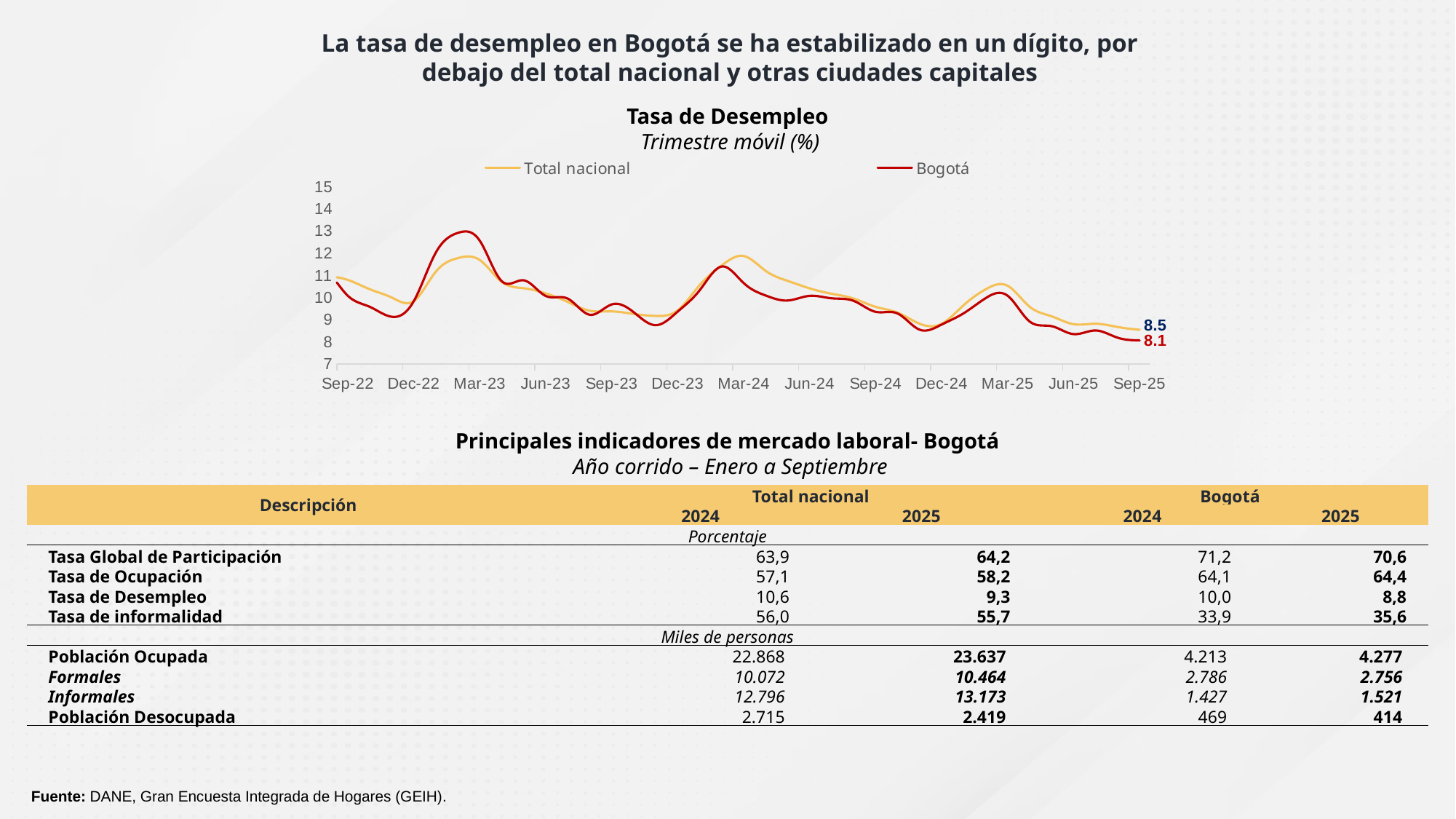
How many date labels are shown on the x axis of the Tasa de Desempleo chart? 13 How many series does the legend of the Tasa de Desempleo chart list? 2 Is the value for Bogotá around Dec-24 greater or less than 9? less At Sep-25, which series has the higher value, Total nacional or Bogotá? Total nacional Is the value for Bogotá around Mar-23 greater or less than 12? greater Which series reaches the highest value anywhere on the Tasa de Desempleo chart? Bogotá Is the value for Total nacional around Mar-24 greater or less than 11? greater What is the difference between the Total nacional and Bogotá values at Sep-25? 0.4 Does the Bogotá line rise or fall between Mar-25 and Sep-25? Fall What is the value for Bogotá at Sep-25 in the Tasa de Desempleo chart? 8.1 What kind of chart is the Tasa de Desempleo chart? Line chart What is the value for Total nacional at Sep-25 in the Tasa de Desempleo chart? 8.5